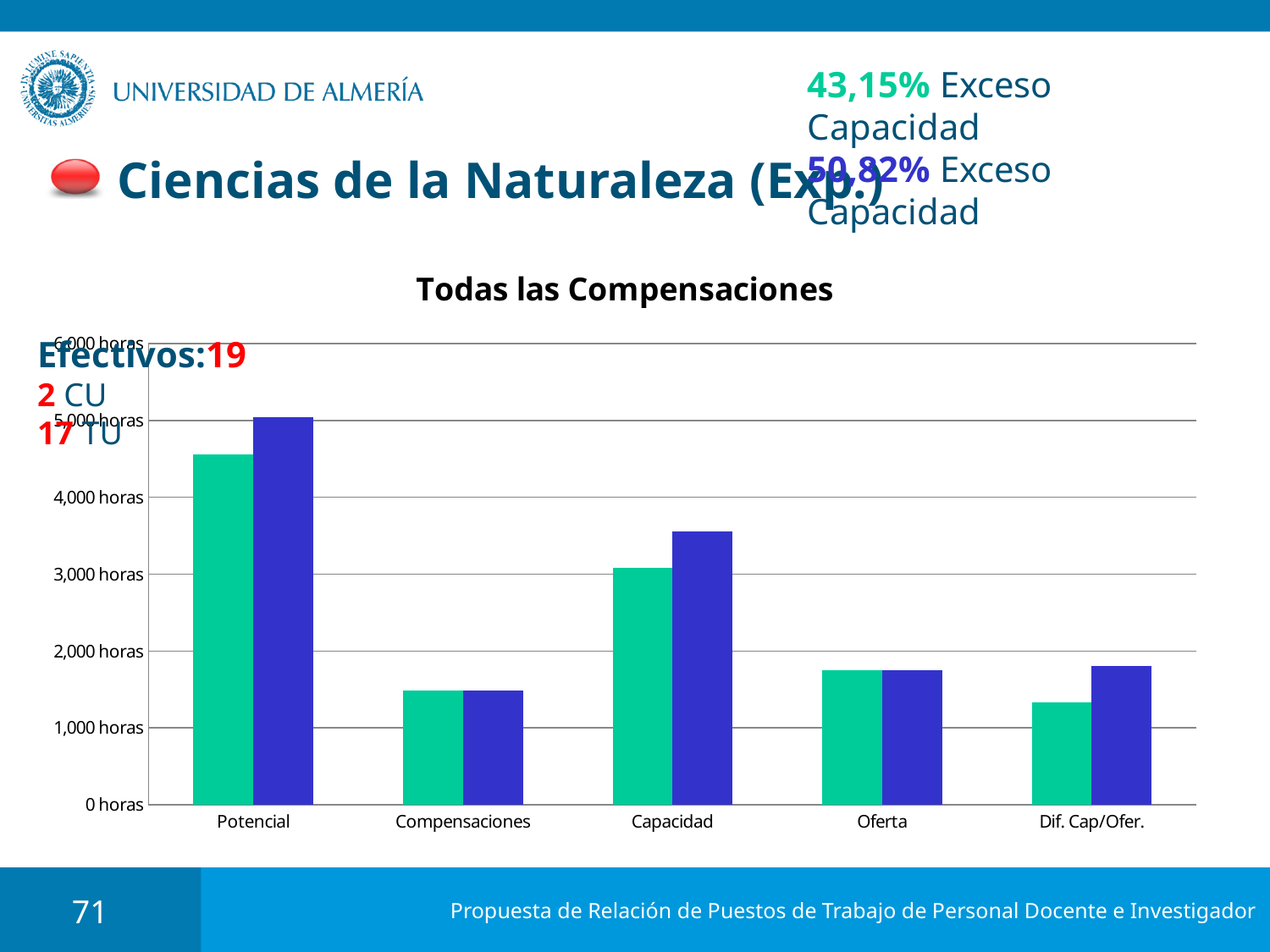
Is the green bar for Capacidad greater or less than 4,000 horas? less What is the title of the chart? Todas las Compensaciones Is the green bar for Potencial greater or less than 4,000 horas? greater Which category has the shortest green bar? Dif. Cap/Ofer. For Capacidad, which bar is taller, the green one or the blue one? the blue one Is the green bar for Oferta greater or less than 1,000 horas? greater Which category has the tallest blue bar? Potencial How many categories are shown on the x axis of the chart? 5 What kind of chart is shown on the slide? bar chart Which category has the tallest green bar? Potencial How many bars are plotted for each category in the chart? 2